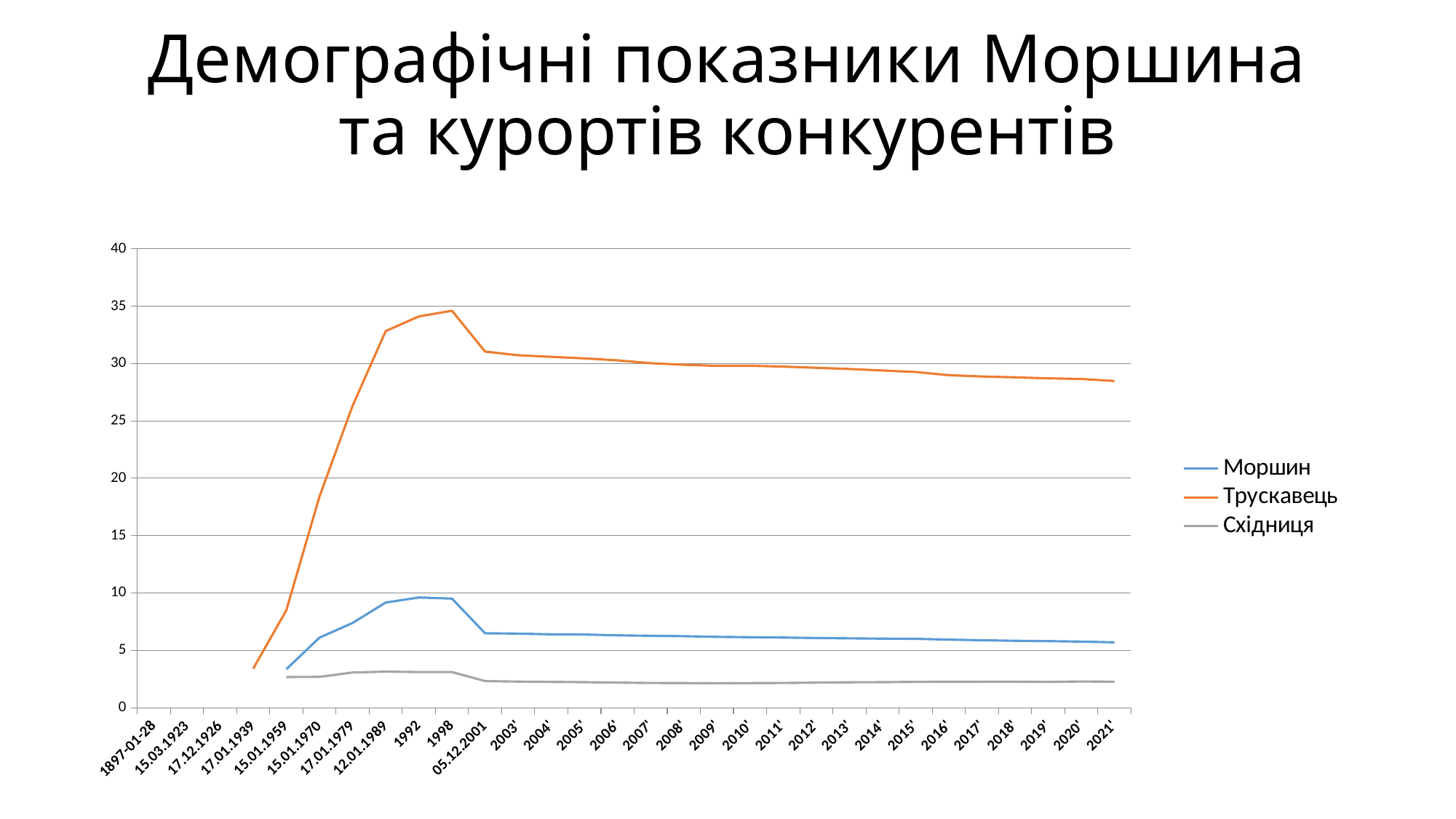
Does the Трускавець line rise or fall from 17.01.1939 to 1998? rise Does the Трускавець line rise or fall from 05.12.2001 to 2021'? fall What kind of chart is shown on the slide? line chart Is the value for Трускавець at 1998 greater or less than 30? greater Is the value for Трускавець at 2021' greater or less than 30? less Which is larger at 2021': the value for Трускавець or the value for Моршин? Трускавець Which series has the highest values across the chart? Трускавець How many series does the legend list? 3 Is the value for Трускавець at 17.01.1939 greater or less than 5? less What colour is the line for Моршин in the legend? blue Which series has the lowest value at 2021'? Східниця